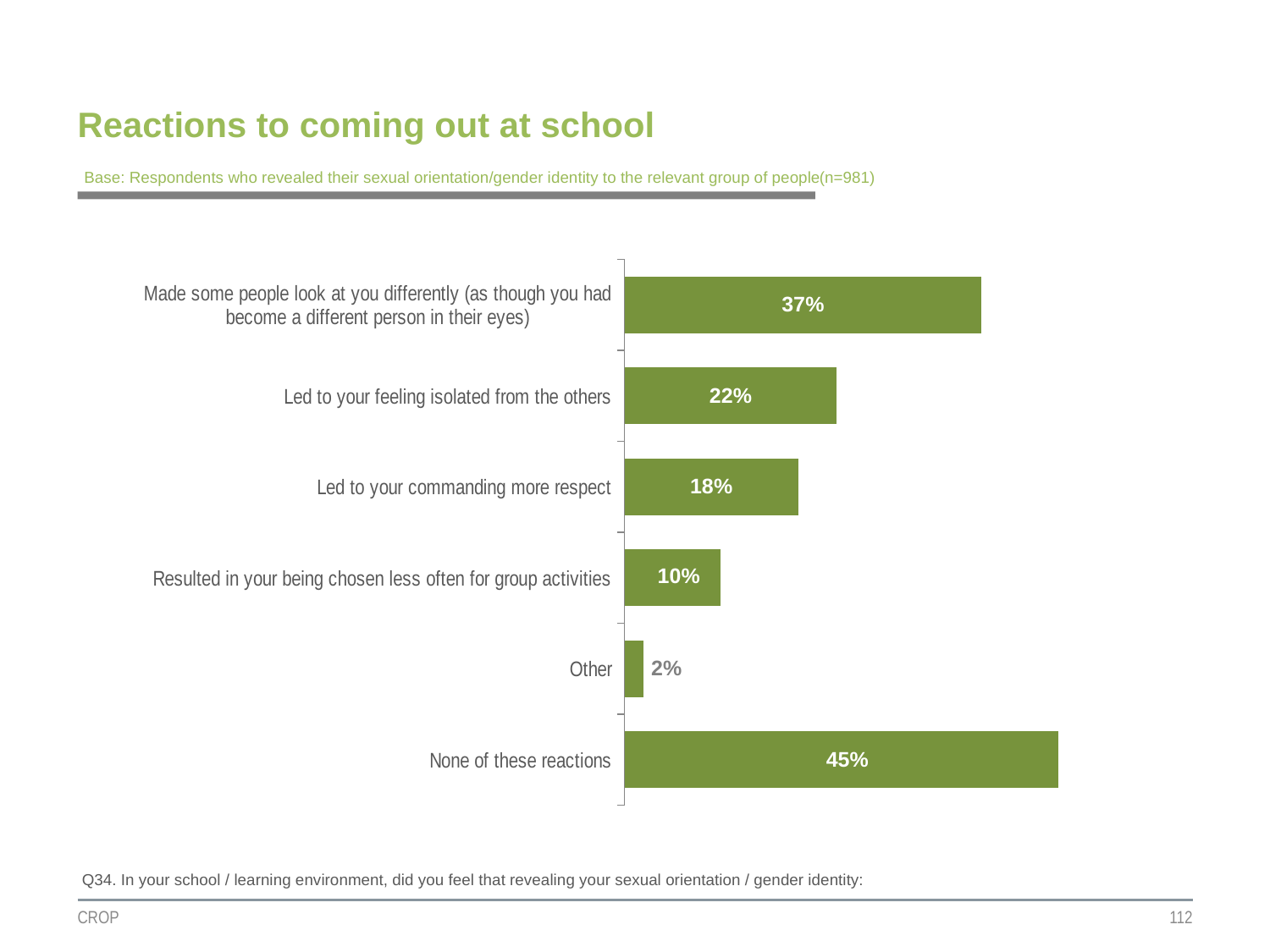
What percentage of respondents said coming out at school resulted in their being chosen less often for group activities? 10% How many reaction categories are shown in the chart? 6 Which reaction category has the highest percentage? None of these reactions What is the difference in percentage points between 'Led to your feeling isolated from the others' and 'Led to your commanding more respect'? 4 Which is larger: the percentage for 'Led to your feeling isolated from the others' or for 'Resulted in your being chosen less often for group activities'? Led to your feeling isolated from the others What percentage of respondents said coming out at school led to their feeling isolated from the others? 22% Which reaction category has the lowest percentage? Other What percentage of respondents selected 'Other'? 2% What is the difference in percentage points between 'None of these reactions' and 'Made some people look at you differently'? 8 What type of chart is shown on the slide? Bar chart What percentage of respondents said coming out at school led to their commanding more respect? 18% What is the title of the slide? Reactions to coming out at school